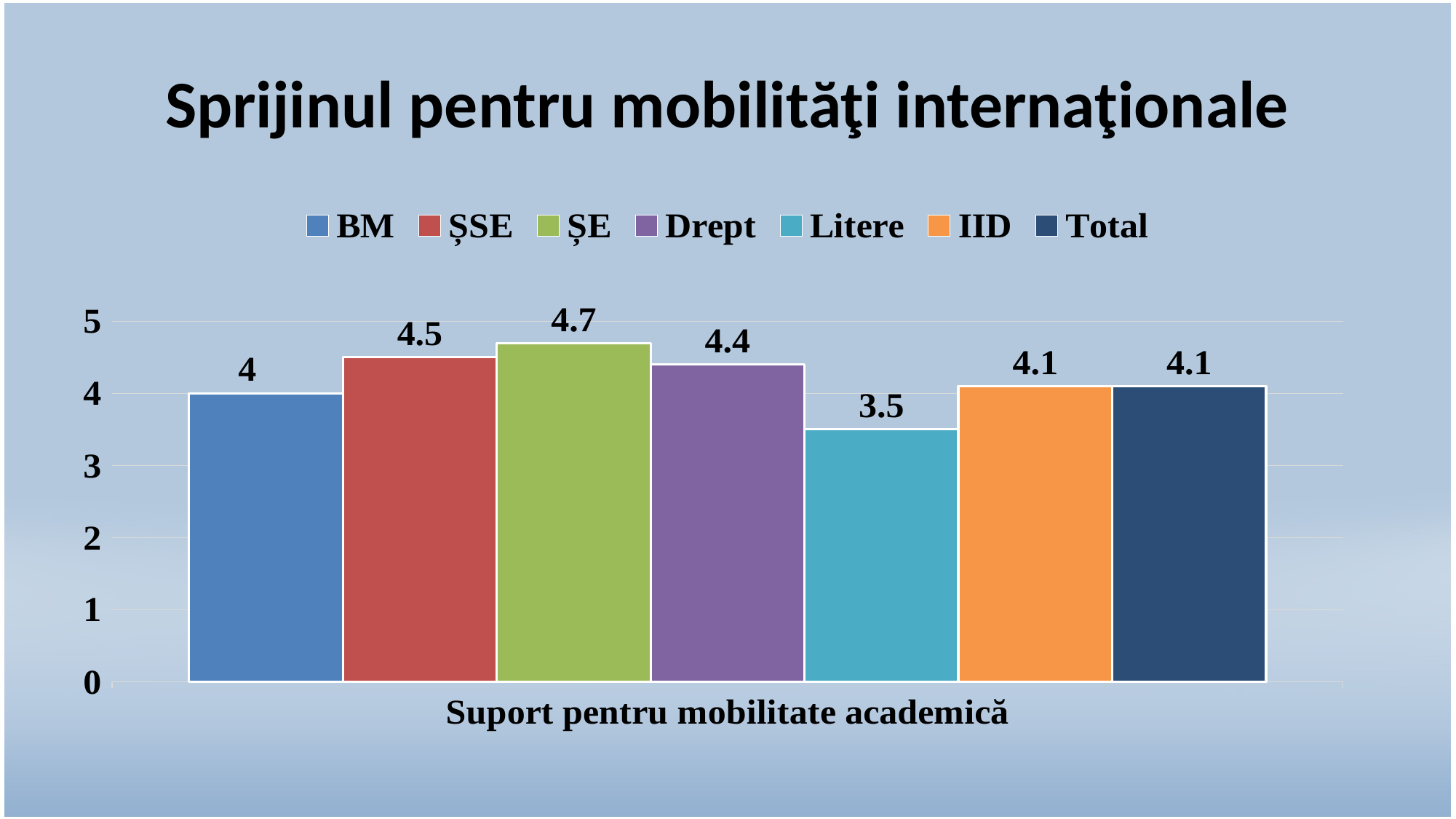
What is the value for Litere? 3.5 What is the value for BM? 4 How many series does the legend list? 7 What is the value for ȘE? 4.7 Which series has the highest value? ȘE Which series has the lowest value? Litere What is the value for Total? 4.1 What is the difference between the values for ȘSE and Drept? 0.1 What kind of chart is shown on the slide? Bar chart Which is larger, the value for ȘSE or the value for IID? ȘSE What is the title of the chart? Sprijinul pentru mobilităţi internaţionale What is the difference between the values for ȘE and Litere? 1.2